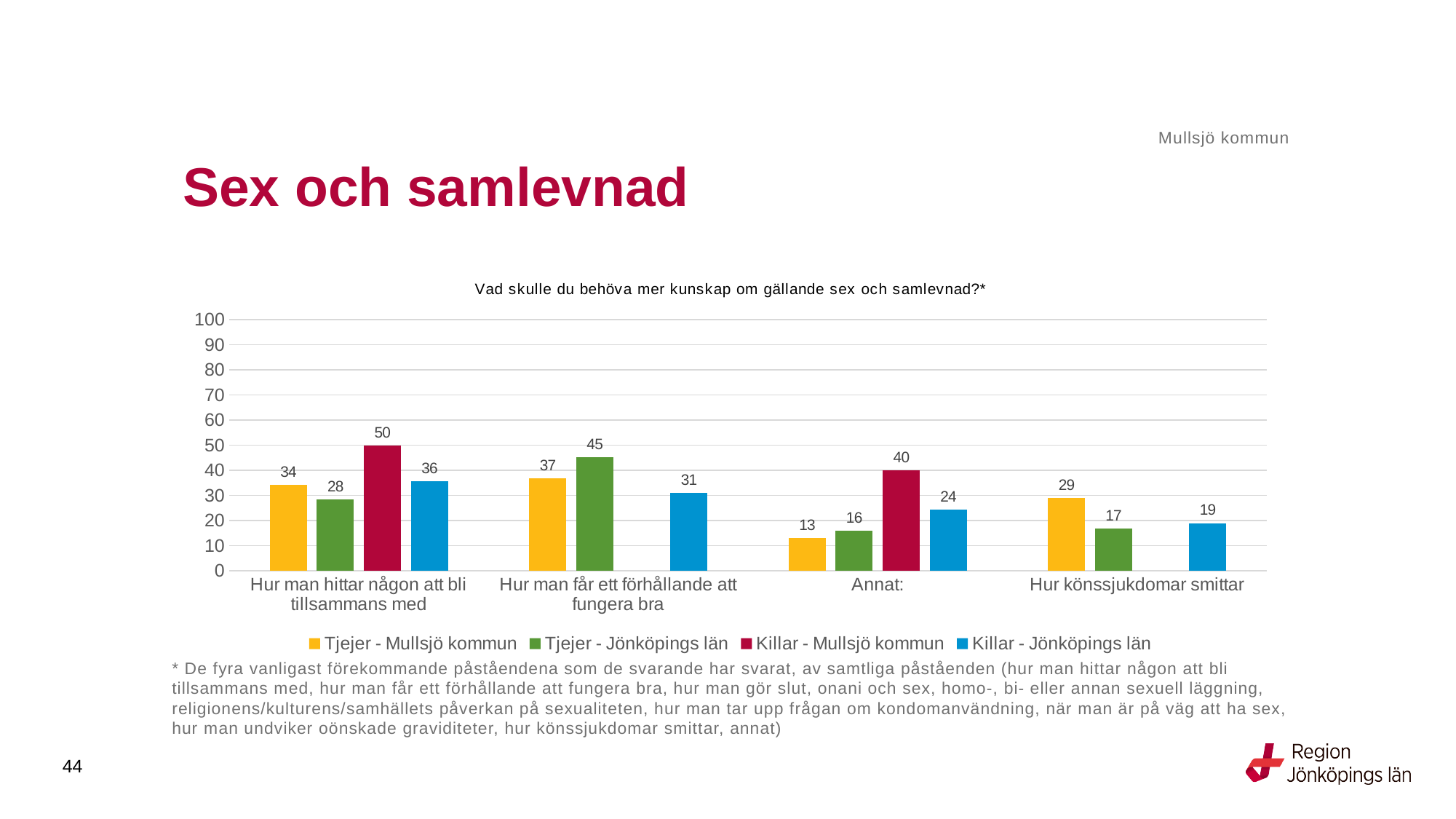
What value is shown for Tjejer - Mullsjö kommun in the category "Hur man hittar någon att bli tillsammans med"? 34 What value is shown for Killar - Mullsjö kommun in the category "Annat:"? 40 What is the difference between Killar - Mullsjö kommun and Tjejer - Jönköpings län in the category "Hur man hittar någon att bli tillsammans med"? 22 What value is shown for Killar - Jönköpings län in the category "Hur könssjukdomar smittar"? 19 Which is larger in the category "Hur könssjukdomar smittar": Tjejer - Mullsjö kommun or Tjejer - Jönköpings län? Tjejer - Mullsjö kommun Is the value for Tjejer - Jönköpings län in the category "Hur man får ett förhållande att fungera bra" greater or less than 40? greater What value is shown for Tjejer - Jönköpings län in the category "Hur man får ett förhållande att fungera bra"? 45 Which series has the highest value in the category "Hur man hittar någon att bli tillsammans med"? Killar - Mullsjö kommun How many series does the legend list? 4 What kind of chart is shown on the slide? Bar chart How many categories are shown on the x axis of the chart? 4 Which series has the lowest value in the category "Annat:"? Tjejer - Mullsjö kommun